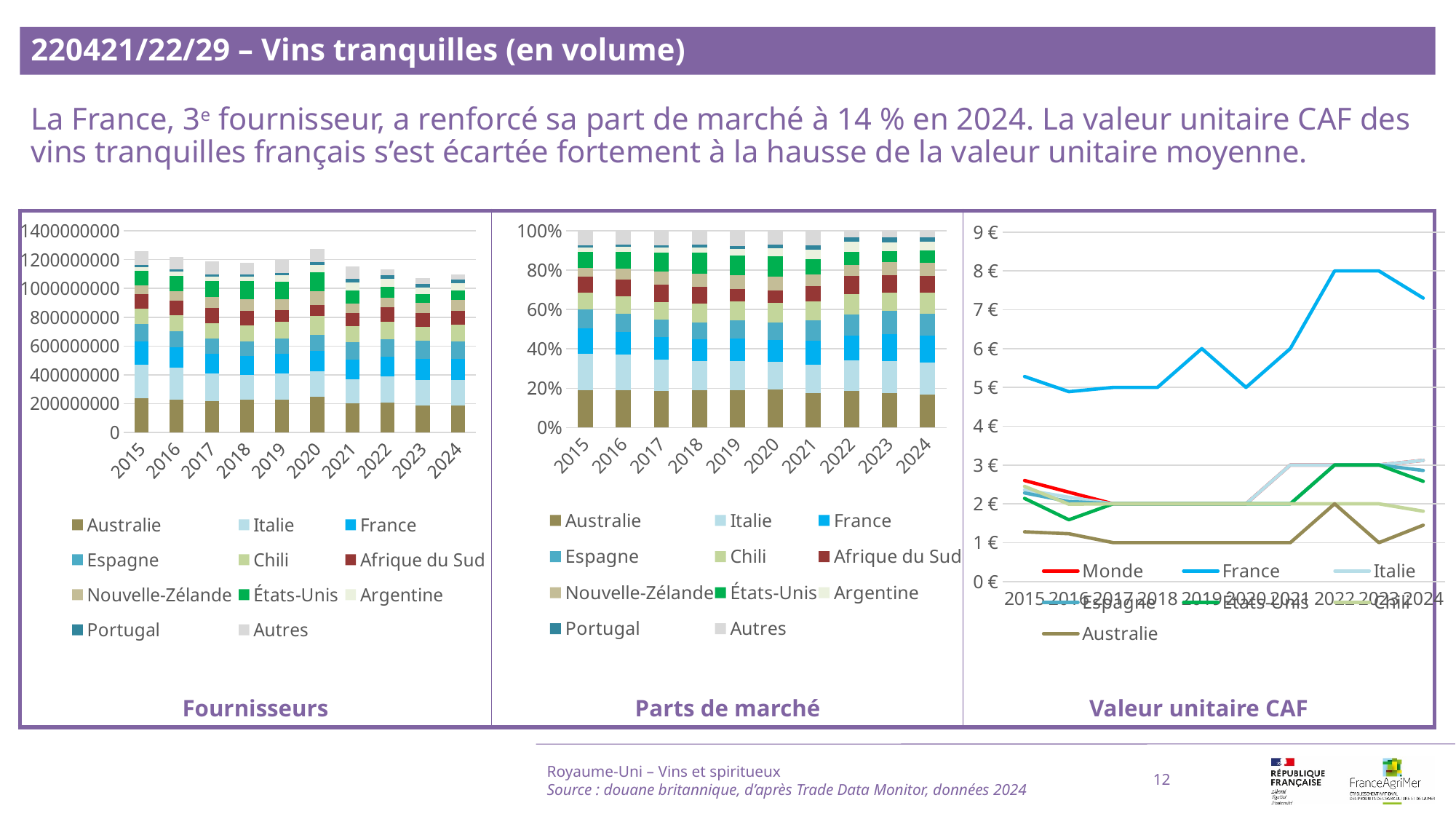
What kind of chart is the 'Valeur unitaire CAF' chart on the right? Line chart How many years are shown on the x axis of the 'Fournisseurs' chart? 10 In the 'Valeur unitaire CAF' chart, which series has the lowest value in 2024? Australie What is the title of the middle chart on the slide? Parts de marché In the 'Valeur unitaire CAF' chart, does the France line rise or fall overall between 2015 and 2023? rise In the 'Fournisseurs' chart, is the total of the 2015 bar greater or less than 1200000000? greater What kind of chart is the 'Fournisseurs' chart on the left? Stacked bar chart In the 'Valeur unitaire CAF' chart, which is larger in 2024: France or Australie? France In the 'Valeur unitaire CAF' chart, which series has the highest value in 2024? France How many series does the legend of the 'Valeur unitaire CAF' chart list? 7 In the 'Valeur unitaire CAF' chart, is the value for France in 2024 greater or less than 7 €? greater How many series does the legend of the 'Parts de marché' chart list? 11